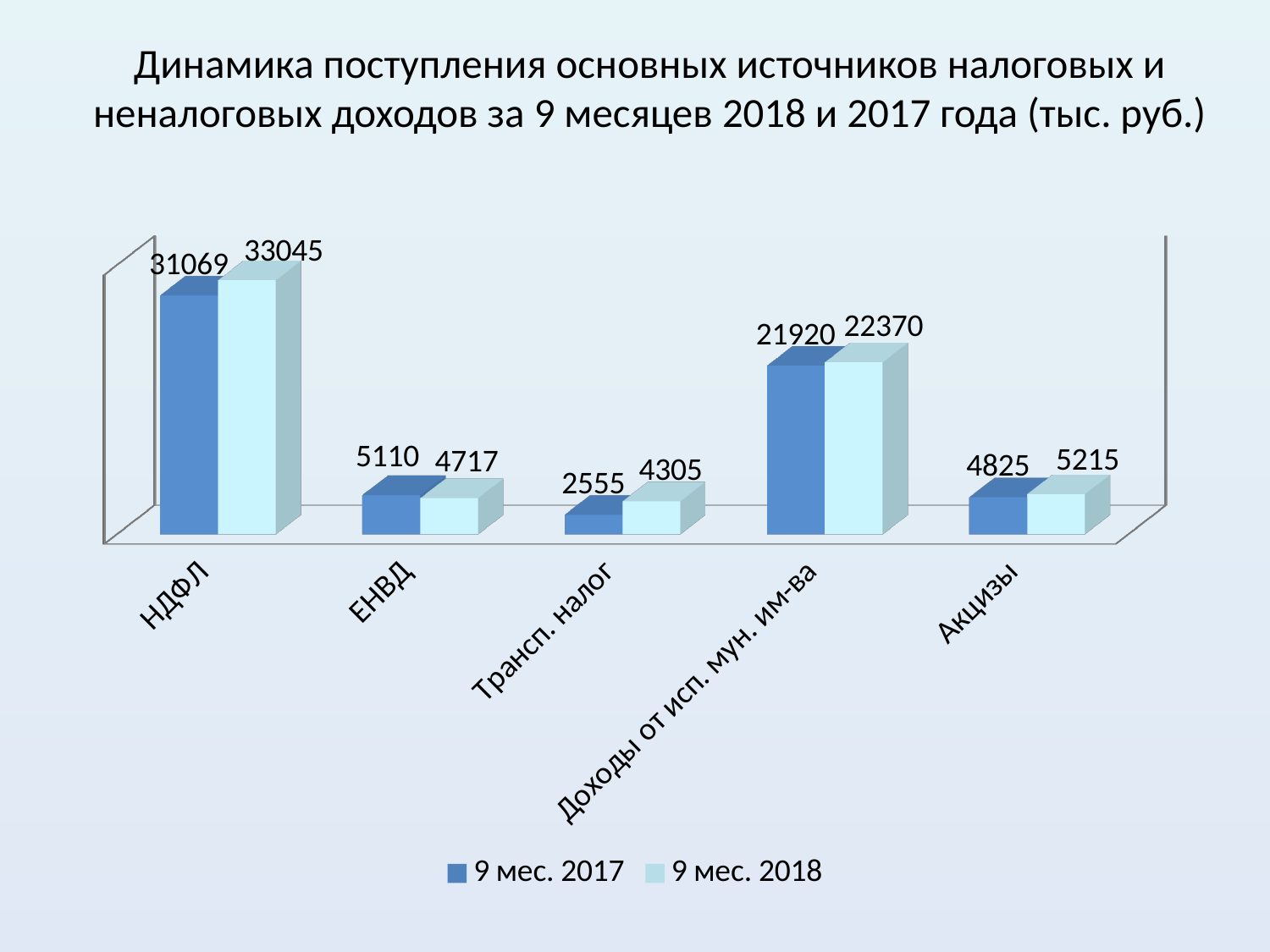
How many categories are shown on the x axis? 5 Which category has the lowest value in the 9 мес. 2018 series? Трансп. налог What is the value for Трансп. налог in the 9 мес. 2017 series? 2555 What is the value for Акцизы in the 9 мес. 2018 series? 5215 Which category has the highest value in the 9 мес. 2017 series? НДФЛ How many series does the legend list? 2 What are the two series named in the legend? 9 мес. 2017 and 9 мес. 2018 Which is larger for Доходы от исп. мун. им-ва: the 9 мес. 2017 value or the 9 мес. 2018 value? 9 мес. 2018 What is the difference between the 9 мес. 2017 and 9 мес. 2018 values for ЕНВД? 393 What is the value for НДФЛ in the 9 мес. 2018 series? 33045 What is the difference between the 9 мес. 2018 and 9 мес. 2017 values for НДФЛ? 1976 What kind of chart is shown on the slide? bar chart